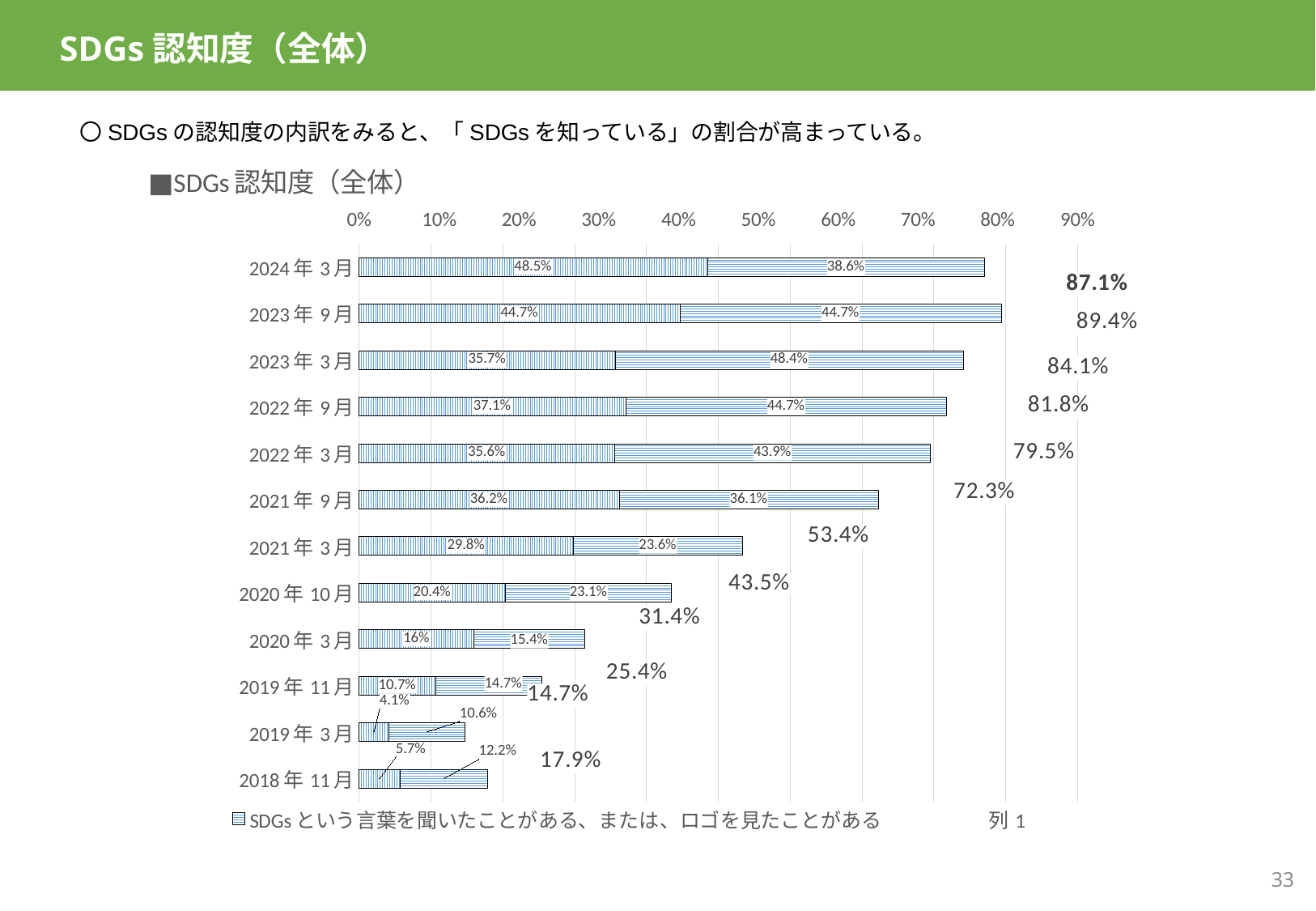
What is the total awareness value shown for 2024年3月? 87.1% What kind of chart is shown on the slide? Stacked bar chart Which survey period has the lowest total awareness value? 2019年3月 (14.7%) What is the difference between the total values for 2023年9月 (89.4%) and 2024年3月 (87.1%)? 2.3 percentage points Which has the larger total value, 2022年3月 or 2021年3月? 2022年3月 How many survey periods (categories) are plotted on the chart? 12 What is the value of the first (left) segment of the bar for 2024年3月? 48.5% Do the total awareness values generally rise or fall from 2018年11月 to 2023年9月? Rise What is the total of the stacked bar for 2019年3月 (4.1% + 10.6%)? 14.7% What is the value of the second (right) segment of the bar for 2023年3月? 48.4% Which survey period has the highest total awareness value? 2023年9月 (89.4%) What is the text of the second legend entry shown below the chart? 列 1